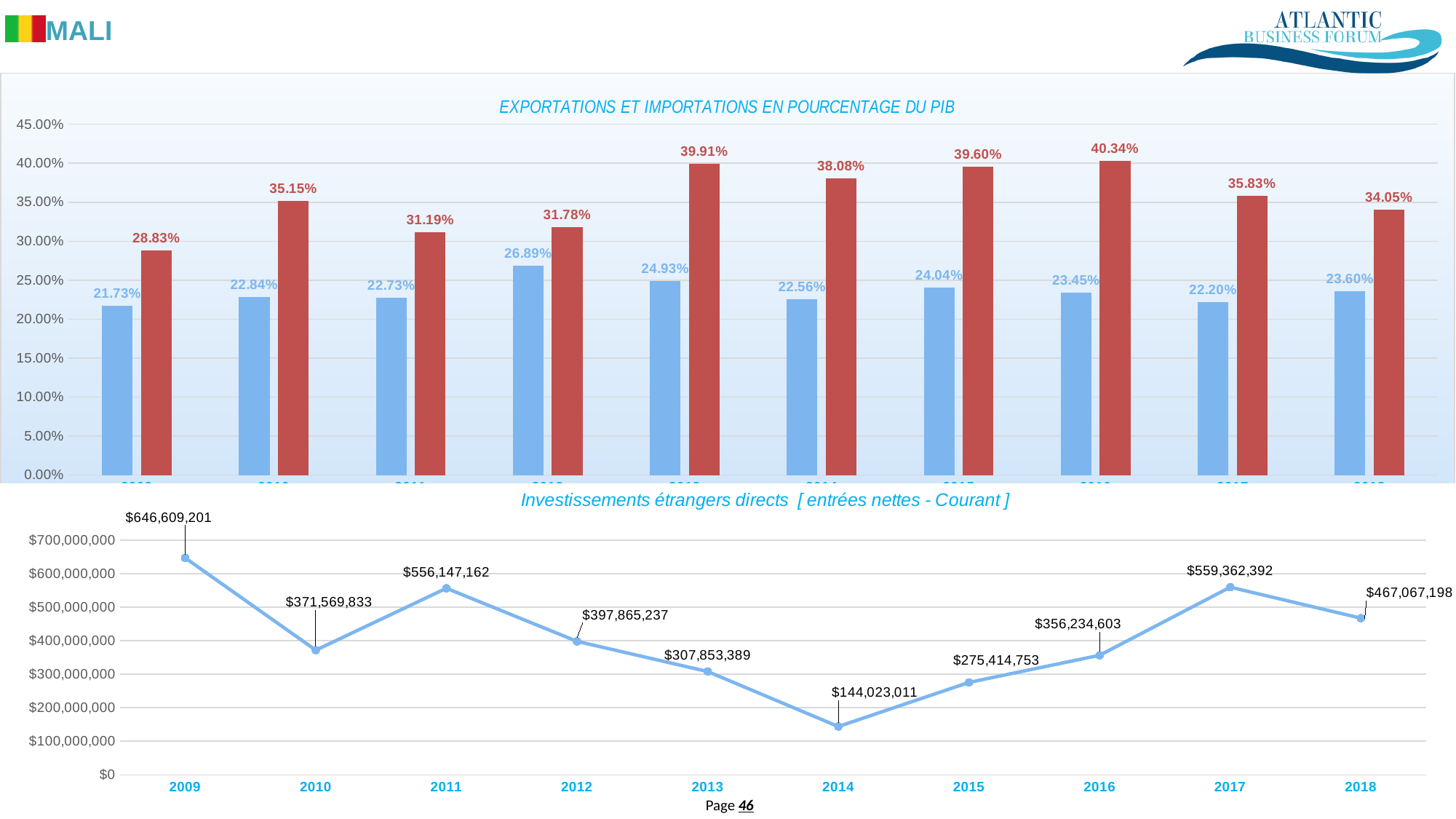
In the bottom chart, which is larger, the value for 2011 or the value for 2018? 2011 In the bottom chart, which year has the lowest value? 2014 In the top chart, what is the highest value shown on any red bar? 40.34% In the bottom chart, what is the value for 2014? $144,023,011 What type of chart is the top chart titled 'EXPORTATIONS ET IMPORTATIONS EN POURCENTAGE DU PIB'? Bar chart In the top chart, how many groups of bars are plotted along the x axis? 10 In the top chart, is the tallest blue bar greater or less than 25.00%? greater In the bottom chart, which year has the highest value? 2009 In the bottom chart, what is the value for 2017? $559,362,392 In the bottom chart, do the values rise or fall from 2014 to 2017? Rise What type of chart is the bottom chart titled 'Investissements étrangers directs [ entrées nettes - Courant ]'? Line chart In the top chart, what is the lowest value shown on any blue bar? 21.73%